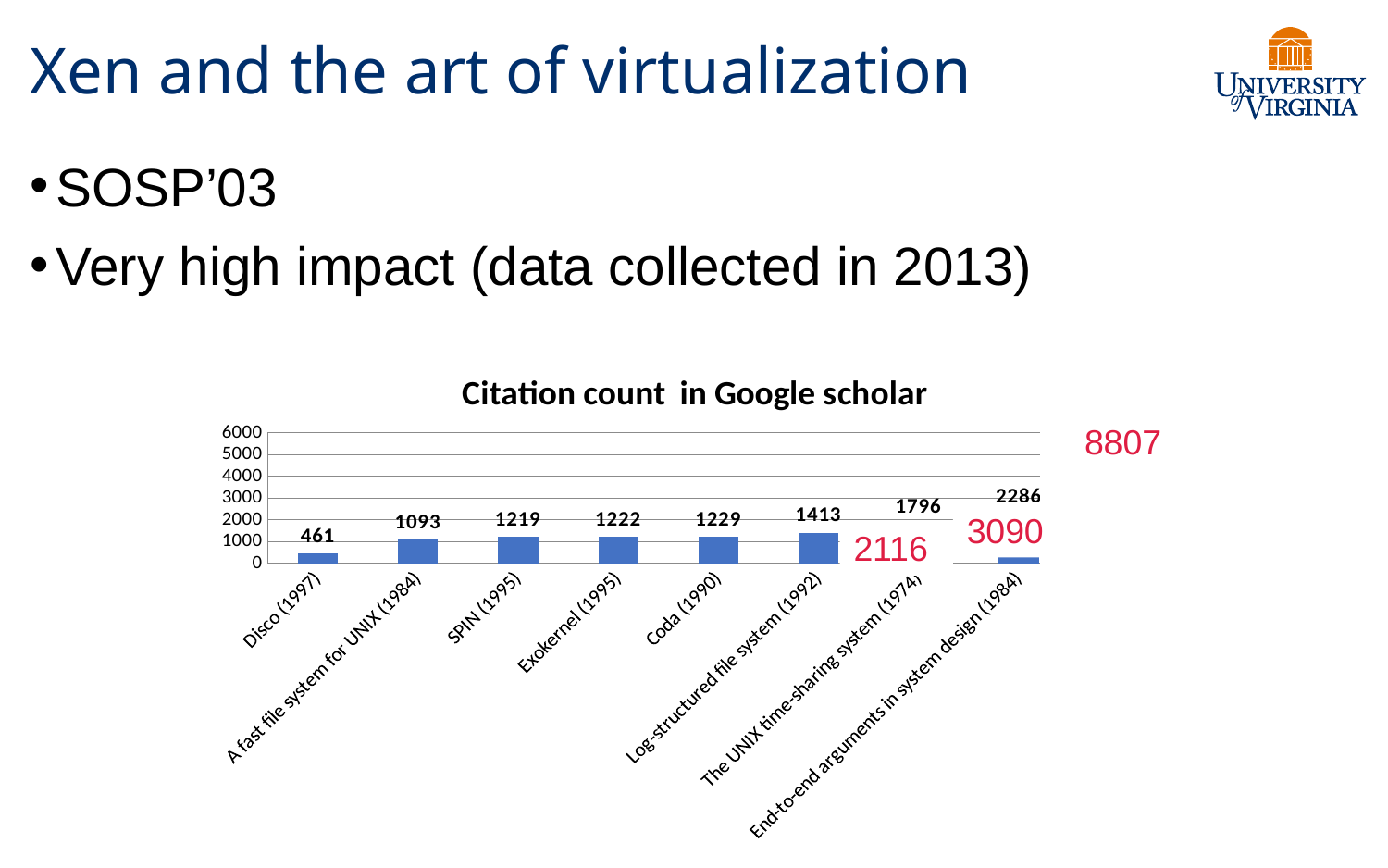
What type of chart is used to show the citation counts? Bar chart Is the citation count for Disco (1997) greater or less than 1000? less What is the citation count for Disco (1997)? 461 What is the citation count shown for A fast file system for UNIX (1984)? 1093 Which paper has the lowest citation count in the chart? Disco (1997) What is the difference in citation count between Coda (1990) and SPIN (1995)? 10 What is the citation count for Coda (1990)? 1229 What is the citation count shown for The UNIX time-sharing system (1974)? 1796 Which has a higher citation count, Log-structured file system (1992) or Coda (1990)? Log-structured file system (1992) What is the difference in citation count between Log-structured file system (1992) and Disco (1997)? 952 What is the citation count for Log-structured file system (1992)? 1413 How many papers are shown on the x axis of the chart? 8